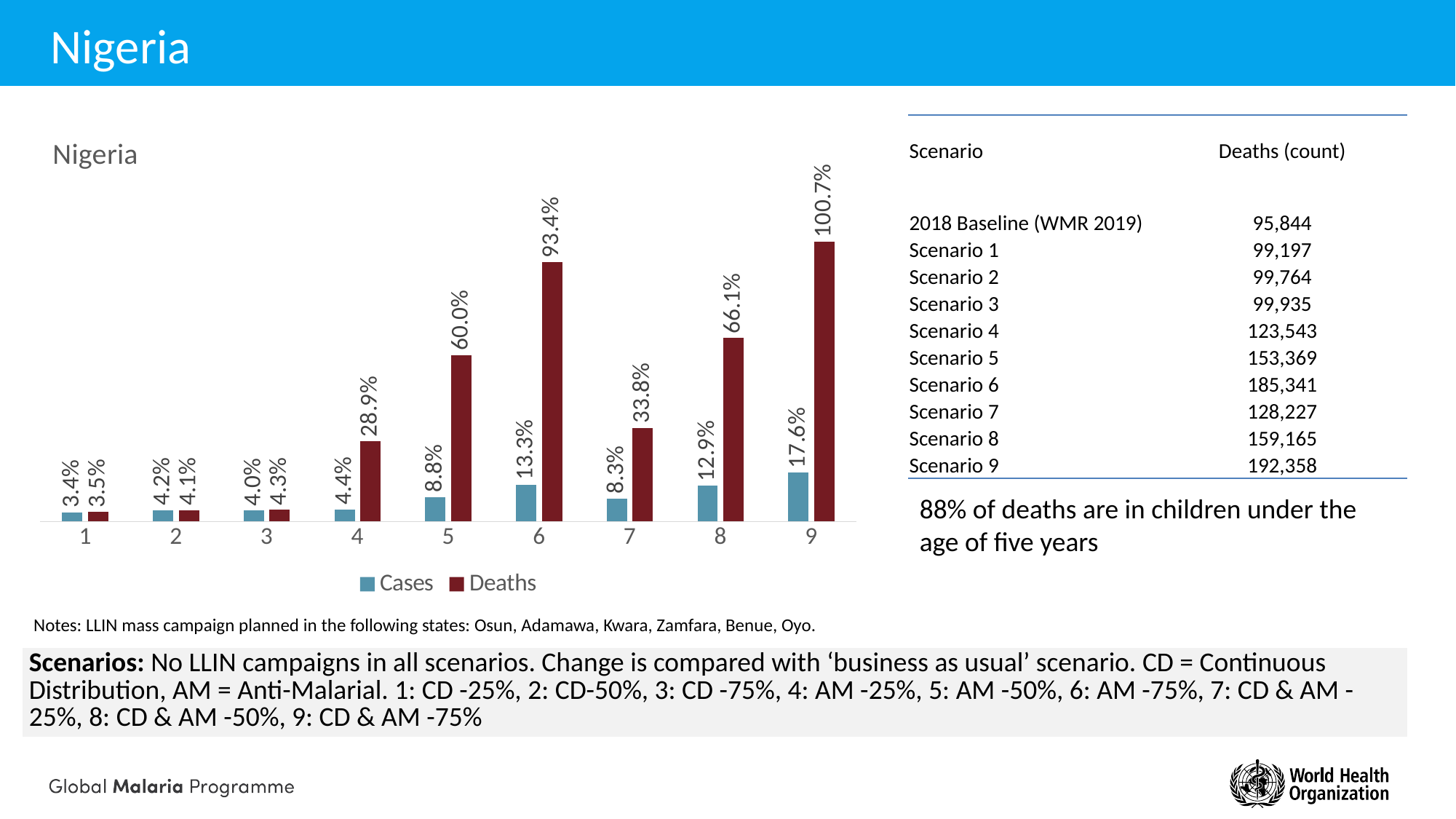
Which series is shown in dark red in the chart? Deaths Which is larger, the Cases value for scenario 8 or the Cases value for scenario 7? Scenario 8 What is the Deaths value for scenario 9? 100.7% Which scenario has the lowest Cases value? 1 What is the difference between the Deaths values for scenario 6 and scenario 5? 33.4% Which scenario has the highest Deaths value? 9 How many series does the chart legend list? 2 What is the Deaths value for scenario 4? 28.9% What is the Cases value for scenario 6? 13.3% What kind of chart is shown on the slide? Bar chart How many scenarios are shown on the x axis of the chart? 9 What is the Cases value for scenario 2? 4.2%